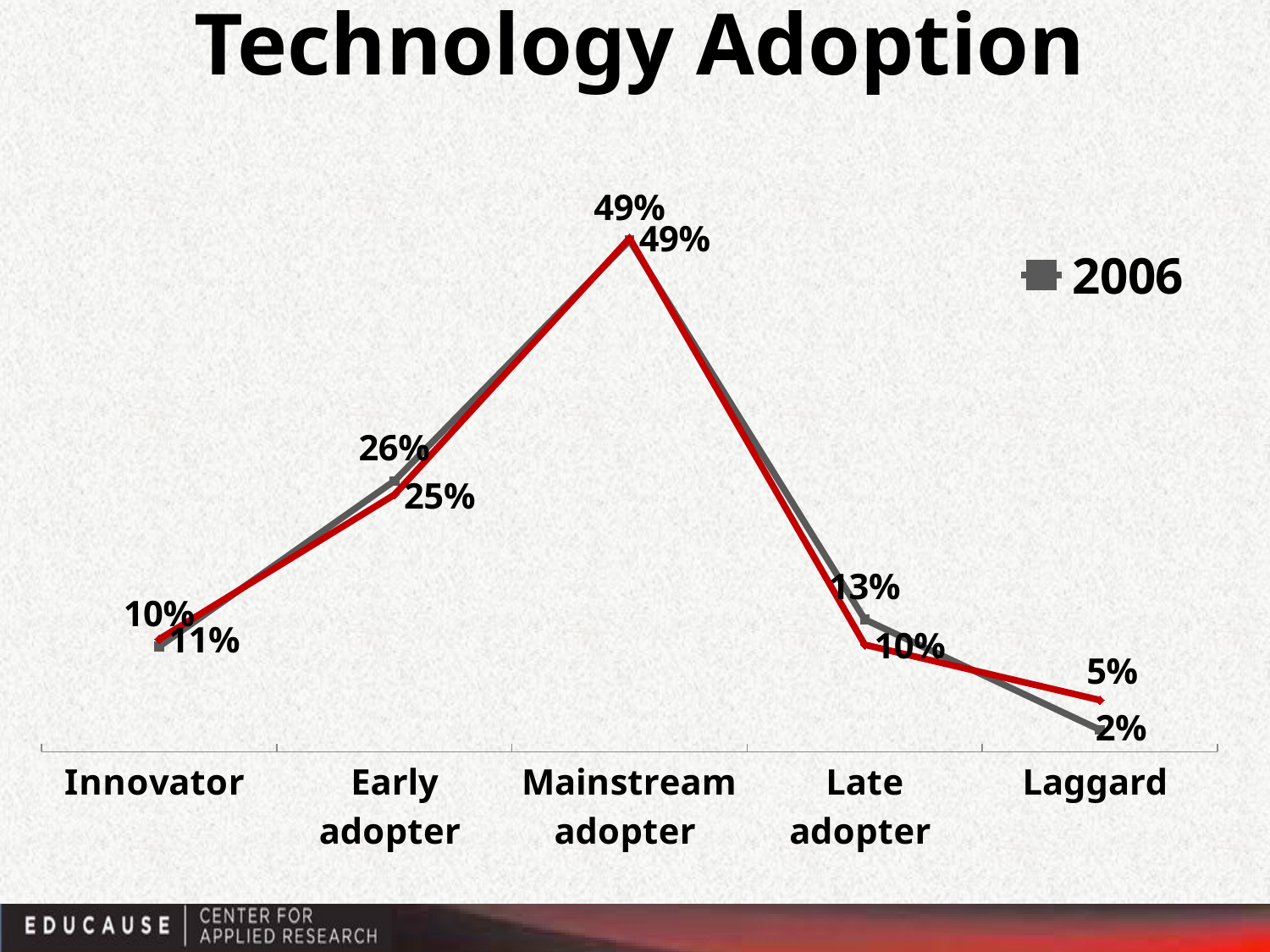
What kind of chart is shown on the slide? Line chart What is the 2006 value for Mainstream adopter? 49% Which category has the highest 2006 value? Mainstream adopter What is the 2006 value for Early adopter? 26% What is the 2006 value for Late adopter? 13% Which series name is readable in the chart's legend? 2006 For 2006, which is larger: the value for Early adopter or the value for Late adopter? Early adopter What is the 2006 value for Laggard? 2% What is the title of the chart on the slide? Technology Adoption How many categories are shown along the x axis of the chart? 5 Which category has the lowest 2006 value? Laggard What is the difference between the 2006 values for Mainstream adopter and Early adopter? 23 percentage points